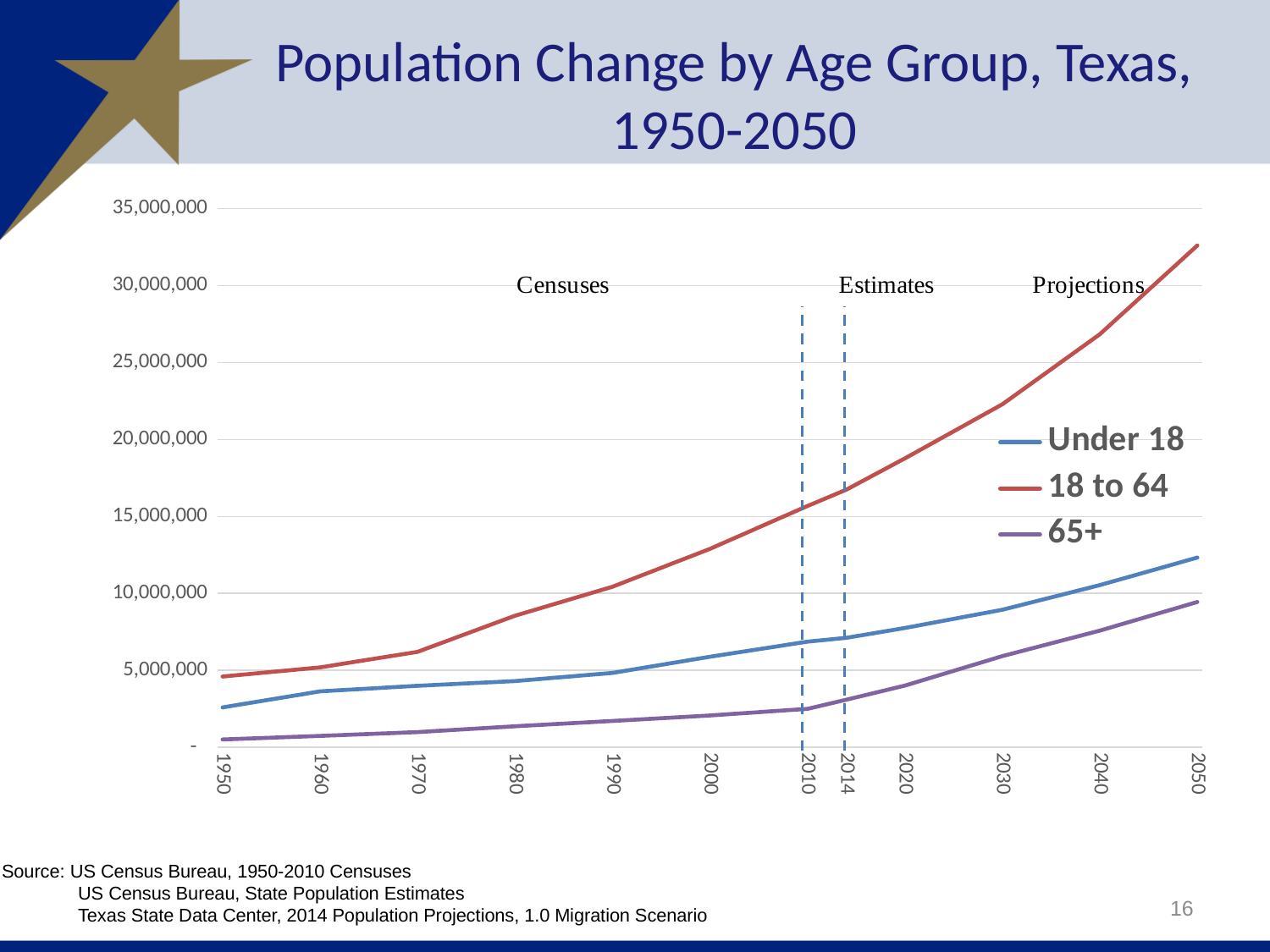
Which age group has the highest population in 2050? 18 to 64 Which age group has the lowest population in 1950? 65+ How many series does the legend list? 3 Is the value for 18 to 64 in 2050 greater or less than 30,000,000? greater Does the 18 to 64 population rise or fall from 1950 to 2050? rise Is the value for Under 18 in 2050 greater or less than 10,000,000? greater How many years are labelled along the x axis? 12 In 2050, which is larger: the Under 18 population or the 65+ population? Under 18 Is the value for 18 to 64 in 1950 greater or less than 5,000,000? less What are the three period labels written across the top of the plot area? Censuses, Estimates, Projections What kind of chart is shown on the slide? line chart